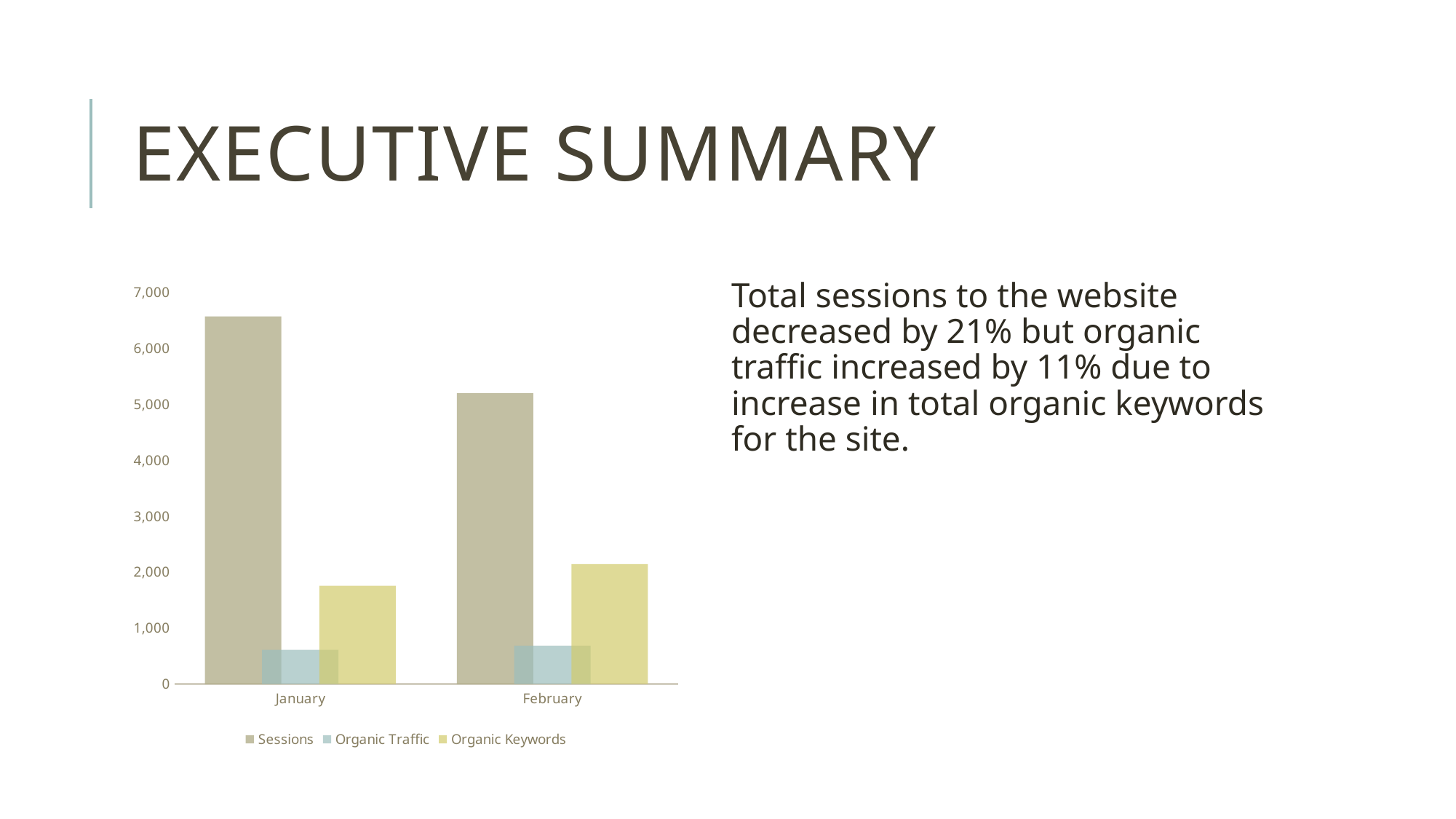
Do the Organic Keywords values rise or fall from January to February? rise What are the names of the series listed in the chart's legend? Sessions, Organic Traffic, Organic Keywords Is the value for Sessions in January greater or less than 6,000? greater How many series does the chart's legend list? 3 Is the value for Organic Keywords in February greater or less than 2,000? greater What kind of chart is shown on the slide? bar chart Is the value for Sessions in February greater or less than 6,000? less How many categories are shown on the x axis of the chart? 2 Which series has the highest value in January? Sessions Which is larger, Sessions in January or Sessions in February? Sessions in January Which series has the lowest value in February? Organic Traffic